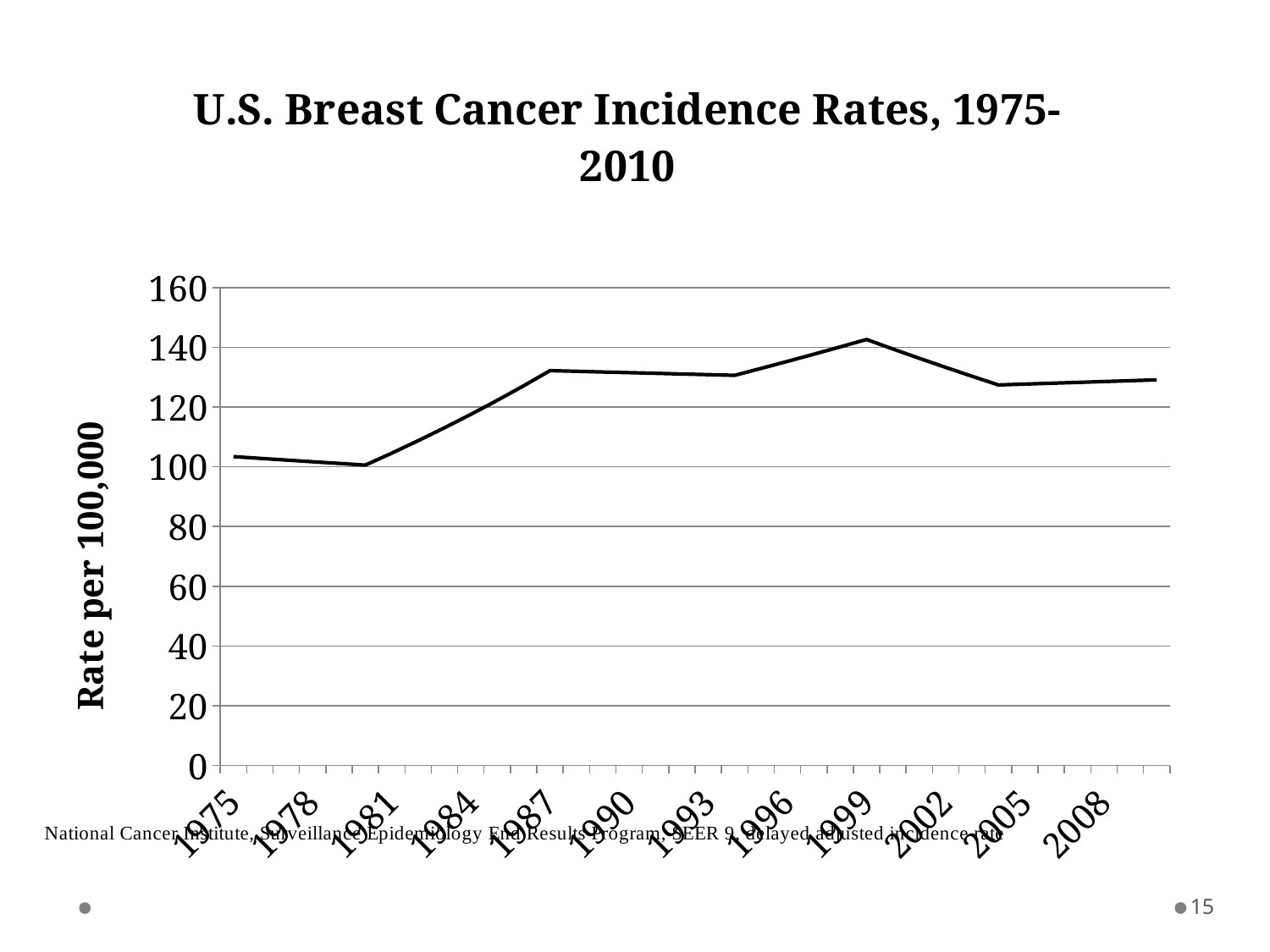
How many year labels are shown along the x axis? 12 Does the incidence rate rise or fall between 1999 and 2005? fall What is the label on the vertical axis of the chart? Rate per 100,000 Is the value for 1987 greater or less than 120? greater Is the value for 1999 greater or less than 120? greater What kind of chart is shown on the slide? line chart Is the value for 1975 greater or less than 120? less Does the incidence rate rise or fall between 1981 and 1987? rise What is the title of the chart? U.S. Breast Cancer Incidence Rates, 1975-2010 Around which labelled year does the line reach its highest value? 1999